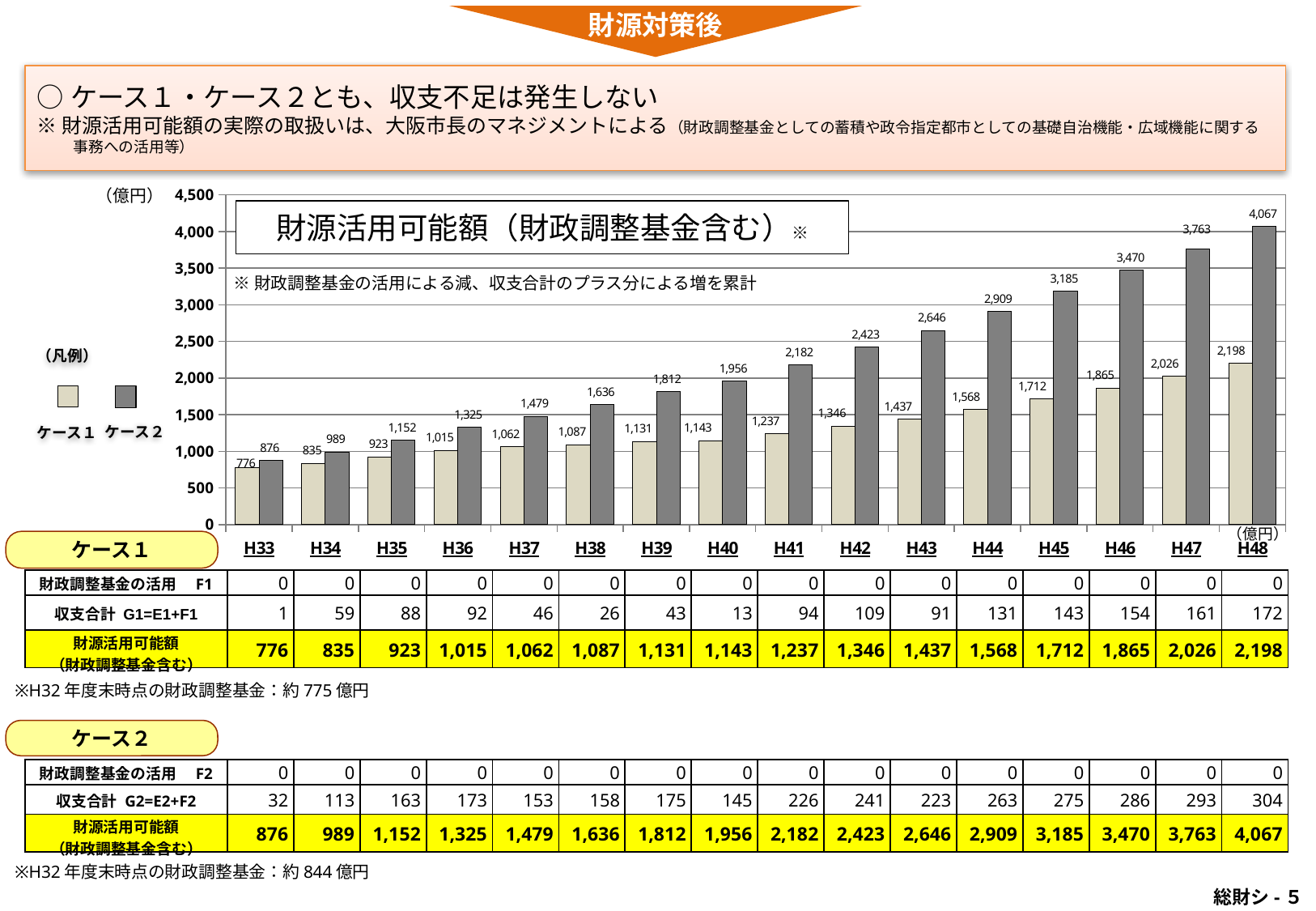
What is the value for ケース２ in H37? 1,479 How many series does the legend list for the chart? 2 Which year has the lowest value for ケース１? H33 Which is larger in H44: ケース１ or ケース２? ケース２ What is the title of the chart? 財源活用可能額（財政調整基金含む） What is the value for ケース１ in H40? 1,143 What is the value for ケース２ in H48? 4,067 Do the values for ケース２ rise or fall from H33 to H48? rise Which year has the highest value for ケース２? H48 What type of chart is shown on the slide? bar chart What is the difference between ケース２ and ケース１ in H48? 1,869 How many fiscal-year categories are plotted along the x axis of the chart? 16